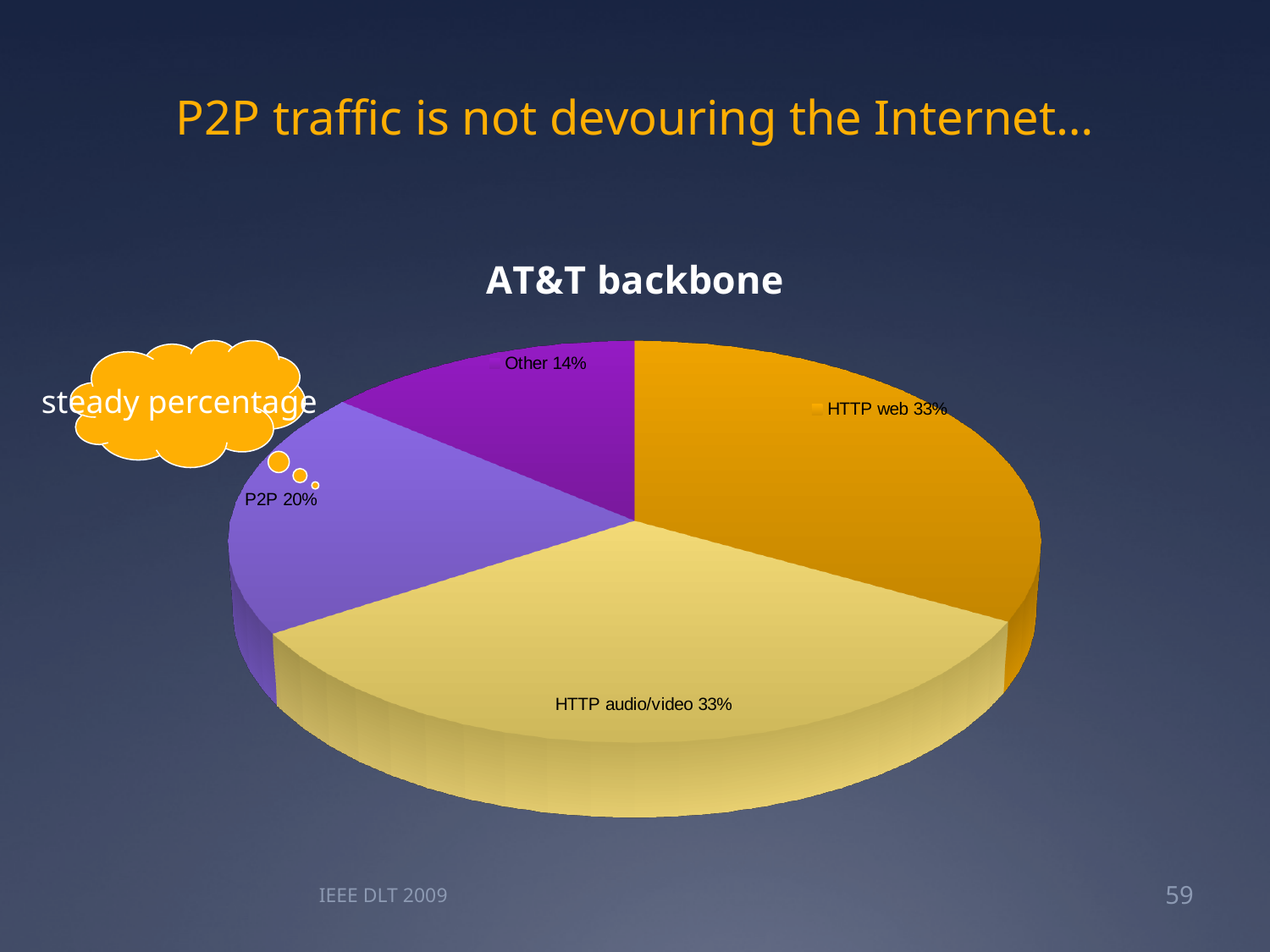
What is the difference between the HTTP web share and the P2P share? 13% What share of the pie does P2P account for? 20% What share of the pie does HTTP audio/video account for? 33% Which is larger, the HTTP web slice or the P2P slice? HTTP web What is the difference between the P2P share and the Other share? 6% Which is larger, the P2P slice or the Other slice? P2P What is the title of the chart? AT&T backbone Which slice of the pie is the smallest? Other What share of the pie does HTTP web account for? 33% How many slices does the pie chart have? 4 What kind of chart is shown on the slide? pie chart